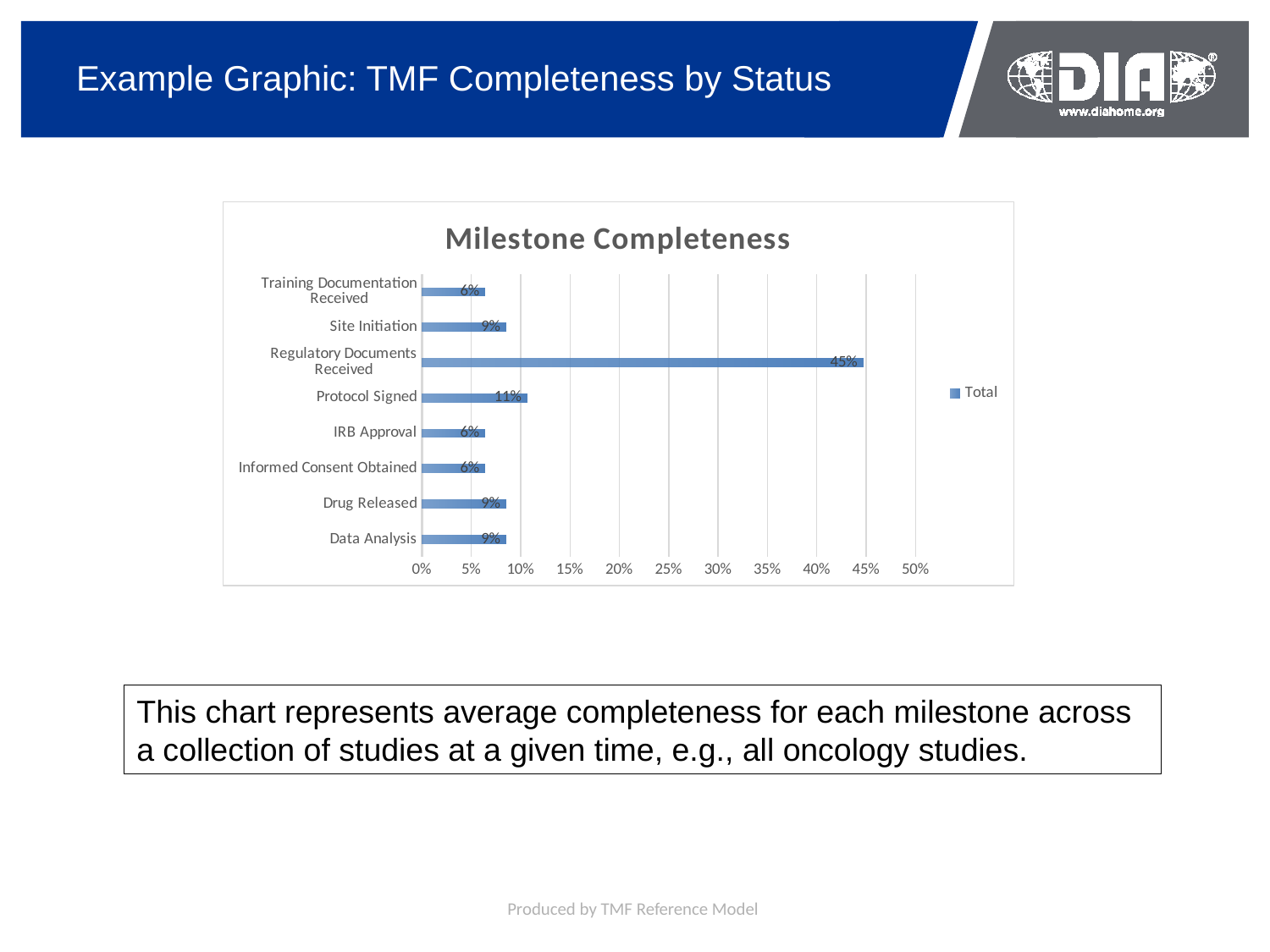
How many milestones are shown in the chart? 8 Which milestone has the highest completeness? Regulatory Documents Received Is the value for Regulatory Documents Received greater or less than 40%? greater What is the title of the chart? Milestone Completeness Which is larger, Protocol Signed or Data Analysis? Protocol Signed What is the value for IRB Approval? 6% What type of chart is shown? Bar chart What is the difference between Regulatory Documents Received and Protocol Signed? 34% What is the difference between Protocol Signed and Drug Released? 2% What is the value for Regulatory Documents Received? 45% What is the value for Protocol Signed? 11% What is the value for Site Initiation? 9%